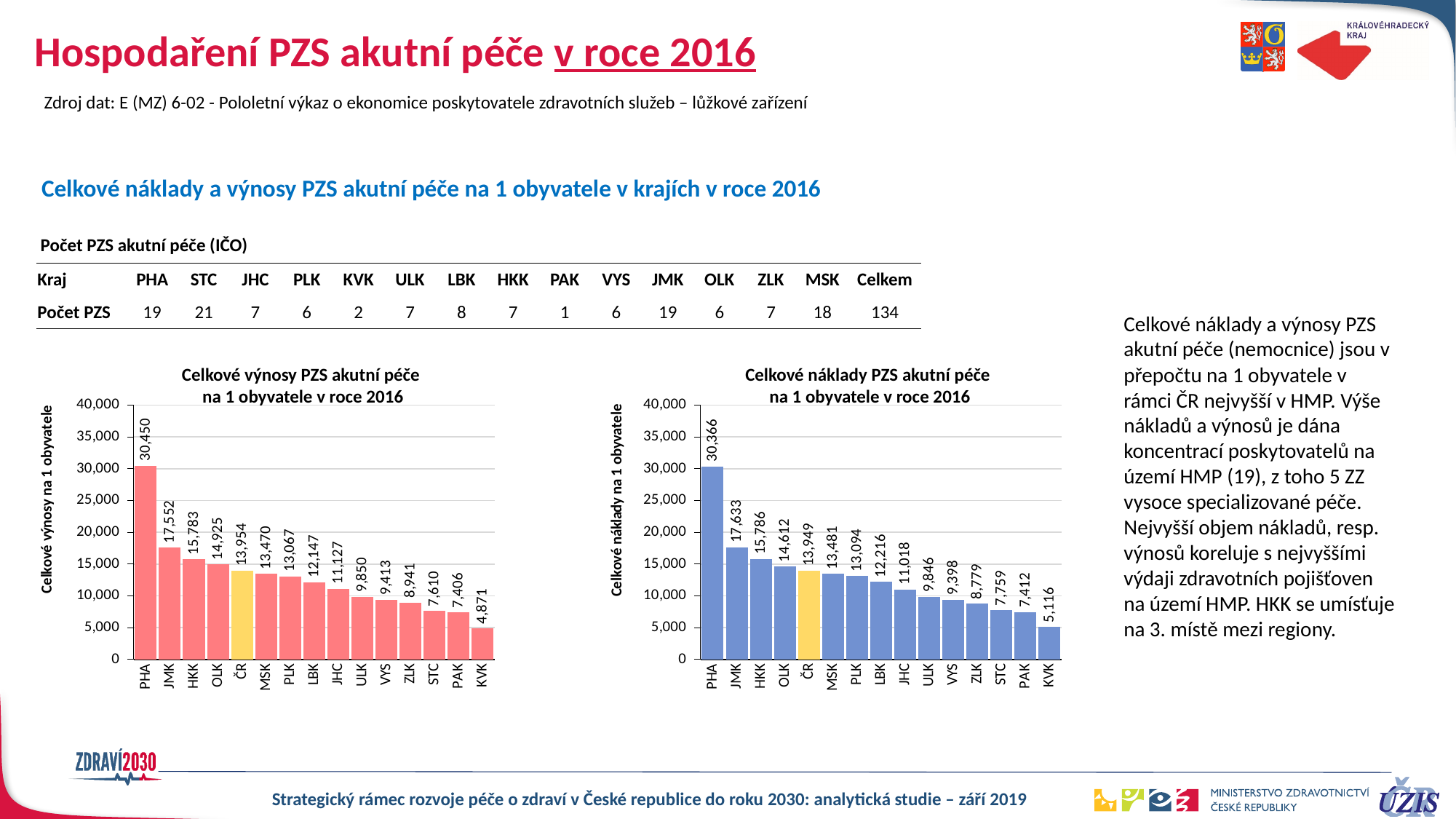
In the chart 'Celkové náklady PZS akutní péče na 1 obyvatele v roce 2016', which bar is coloured differently (yellow) from the others? ČR In the chart 'Celkové výnosy PZS akutní péče na 1 obyvatele v roce 2016', what is the value for KVK? 4,871 In the chart 'Celkové výnosy PZS akutní péče na 1 obyvatele v roce 2016', which category has the highest value? PHA In the chart 'Celkové výnosy PZS akutní péče na 1 obyvatele v roce 2016', what is the value for HKK? 15,783 In the chart 'Celkové výnosy PZS akutní péče na 1 obyvatele v roce 2016', is the value for ULK greater or less than 10,000? less In the chart 'Celkové náklady PZS akutní péče na 1 obyvatele v roce 2016', which is larger, the value for OLK or the value for MSK? OLK In the chart 'Celkové náklady PZS akutní péče na 1 obyvatele v roce 2016', what is the value for ČR? 13,949 How many categories are shown on the x axis of the chart 'Celkové náklady PZS akutní péče na 1 obyvatele v roce 2016'? 15 What kind of chart is 'Celkové výnosy PZS akutní péče na 1 obyvatele v roce 2016'? bar chart In the chart 'Celkové náklady PZS akutní péče na 1 obyvatele v roce 2016', do the values rise or fall from left to right along the x axis? fall In the chart 'Celkové náklady PZS akutní péče na 1 obyvatele v roce 2016', which category has the lowest value? KVK In the chart 'Celkové výnosy PZS akutní péče na 1 obyvatele v roce 2016', what is the difference between the values for PHA and JMK? 12,898